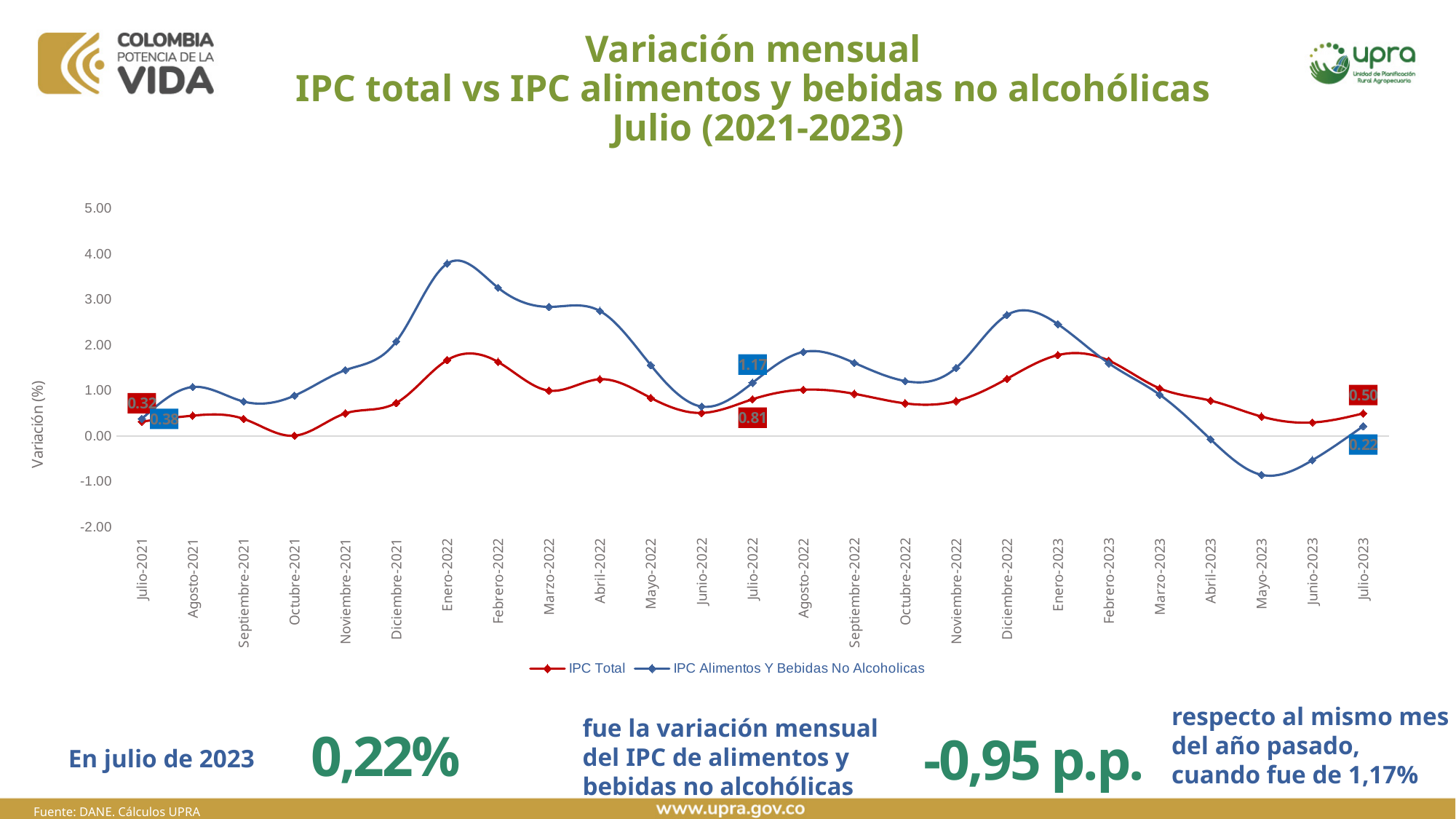
In Julio-2023, which series has the larger value, IPC Total or IPC Alimentos Y Bebidas No Alcoholicas? IPC Total In which month does the IPC Alimentos Y Bebidas No Alcoholicas series reach its lowest value? Mayo-2023 In which month does the IPC Alimentos Y Bebidas No Alcoholicas series reach its highest value? Enero-2022 How many series does the legend list? 2 What is the value of IPC Total for Julio-2023? 0.50 What is the difference between IPC Alimentos Y Bebidas No Alcoholicas and IPC Total in Julio-2022? 0.36 What kind of chart is shown on the slide? line chart What is the value of IPC Alimentos Y Bebidas No Alcoholicas for Julio-2023? 0.22 What is the value of IPC Alimentos Y Bebidas No Alcoholicas for Julio-2022? 1.17 How many months are shown on the x axis? 25 What is the value of IPC Total for Julio-2021? 0.32 Is the value of IPC Alimentos Y Bebidas No Alcoholicas for Enero-2022 greater or less than 3.00? greater